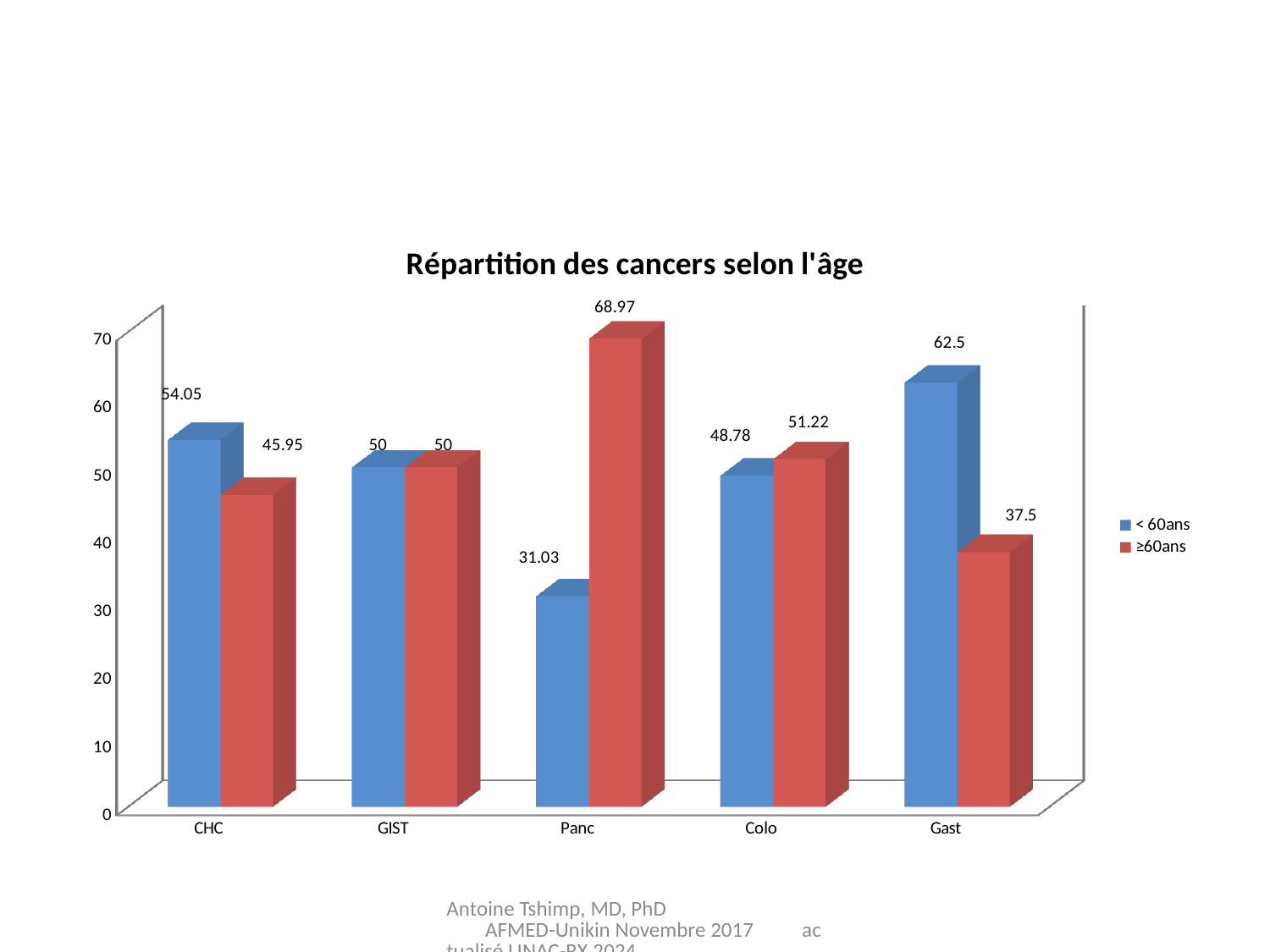
What is the difference between the ≥60ans and < 60ans values for Panc? 37.94 For Gast, which series has the larger value, < 60ans or ≥60ans? < 60ans What is the value for CHC in the ≥60ans series? 45.95 How many categories are shown on the x axis? 5 What is the title of the chart? Répartition des cancers selon l'âge What is the value for Panc in the ≥60ans series? 68.97 How many series does the legend list? 2 What is the value for GIST in the < 60ans series? 50 What kind of chart is shown on the slide? Bar chart Which category has the lowest value in the < 60ans series? Panc What is the value for Gast in the < 60ans series? 62.5 Which category has the highest value in the ≥60ans series? Panc